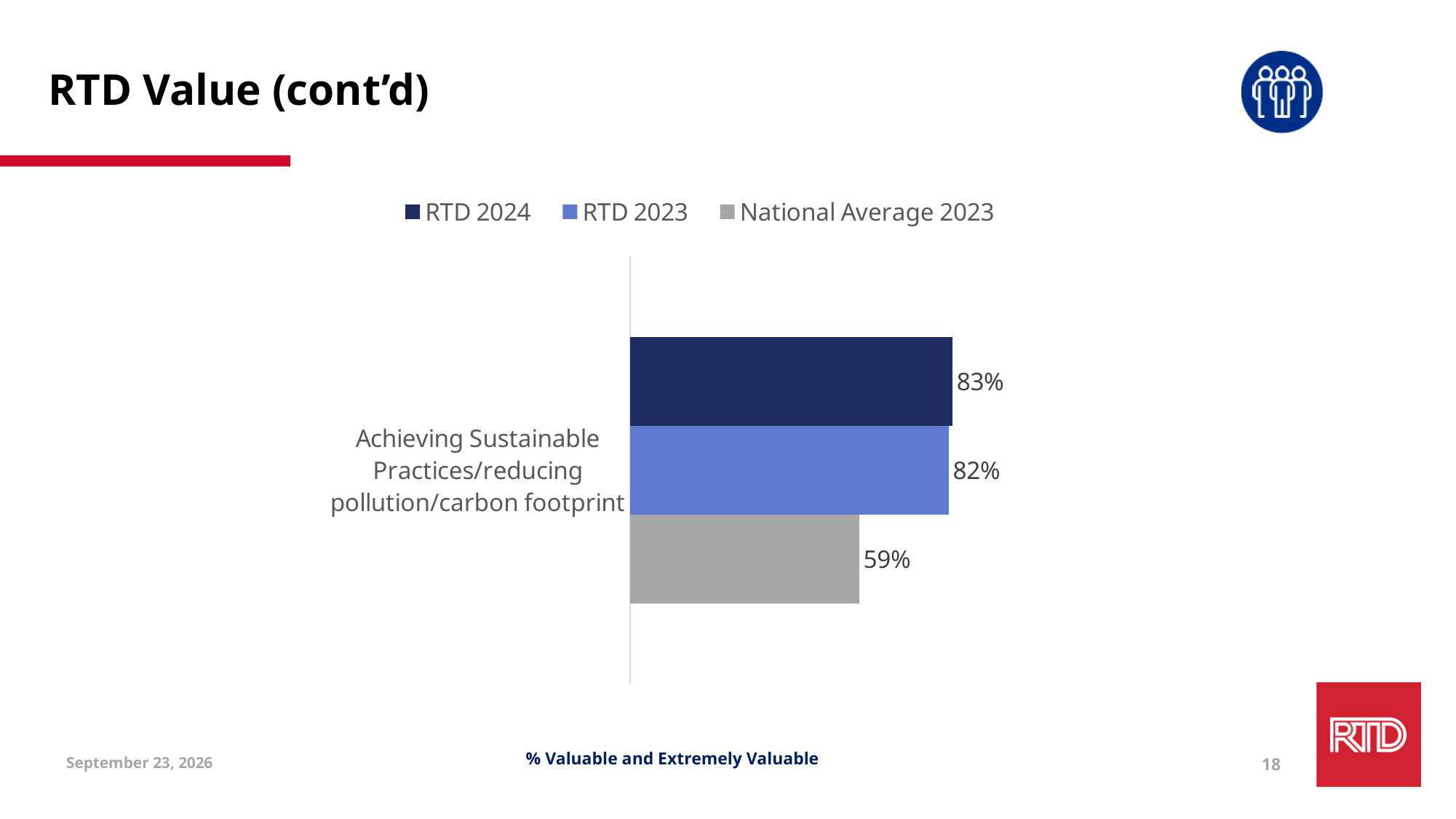
What is the difference between the RTD 2024 value and the RTD 2023 value? 1% What is the value for National Average 2023 for Achieving Sustainable Practices/reducing pollution/carbon footprint? 59% How many series does the legend list? 3 What kind of chart is shown on the slide? Bar chart What is the value for RTD 2023 for Achieving Sustainable Practices/reducing pollution/carbon footprint? 82% Which series has the lowest value on the chart? National Average 2023 What is the difference between the RTD 2024 value and the National Average 2023 value? 24% Which series has the highest value on the chart? RTD 2024 What is the value for RTD 2024 for Achieving Sustainable Practices/reducing pollution/carbon footprint? 83% How many categories are shown on the chart? 1 What colour is the bar for National Average 2023? Grey Which is larger, the RTD 2023 value or the National Average 2023 value? RTD 2023